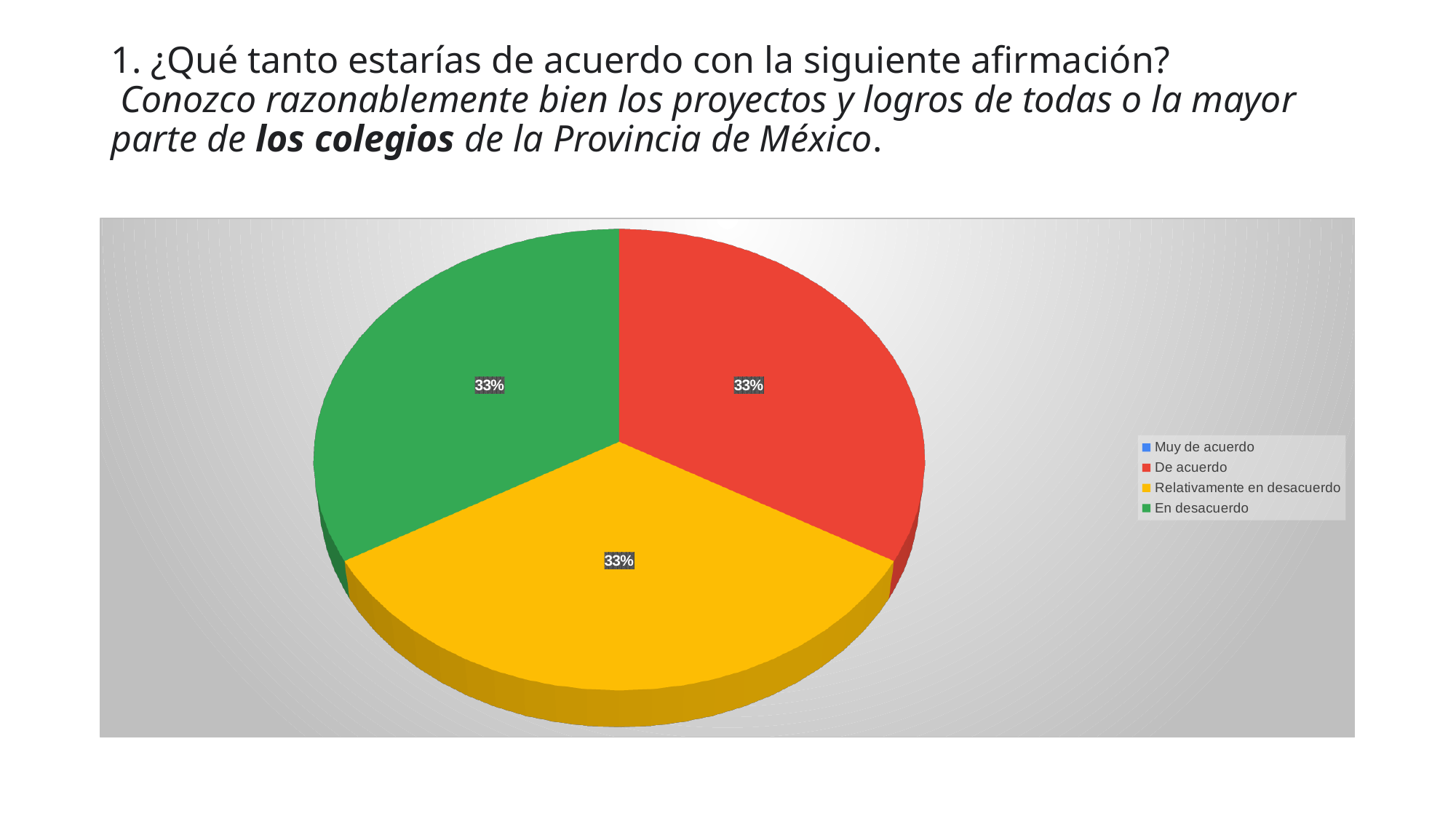
What kind of chart is shown on the slide? pie chart How many slices with a data label are visible in the pie? 3 What share of the pie is labelled for the 'De acuerdo' slice? 33% What colour is the 'Relativamente en desacuerdo' slice? yellow How many entries does the legend list? 4 What share of the pie is labelled for the 'En desacuerdo' slice? 33% What share of the pie is labelled for the 'Relativamente en desacuerdo' slice? 33% Is the share for 'De acuerdo' greater or less than 25%? greater Which legend entry has no visible slice in the pie? Muy de acuerdo Is the share for 'En desacuerdo' greater or less than 50%? less